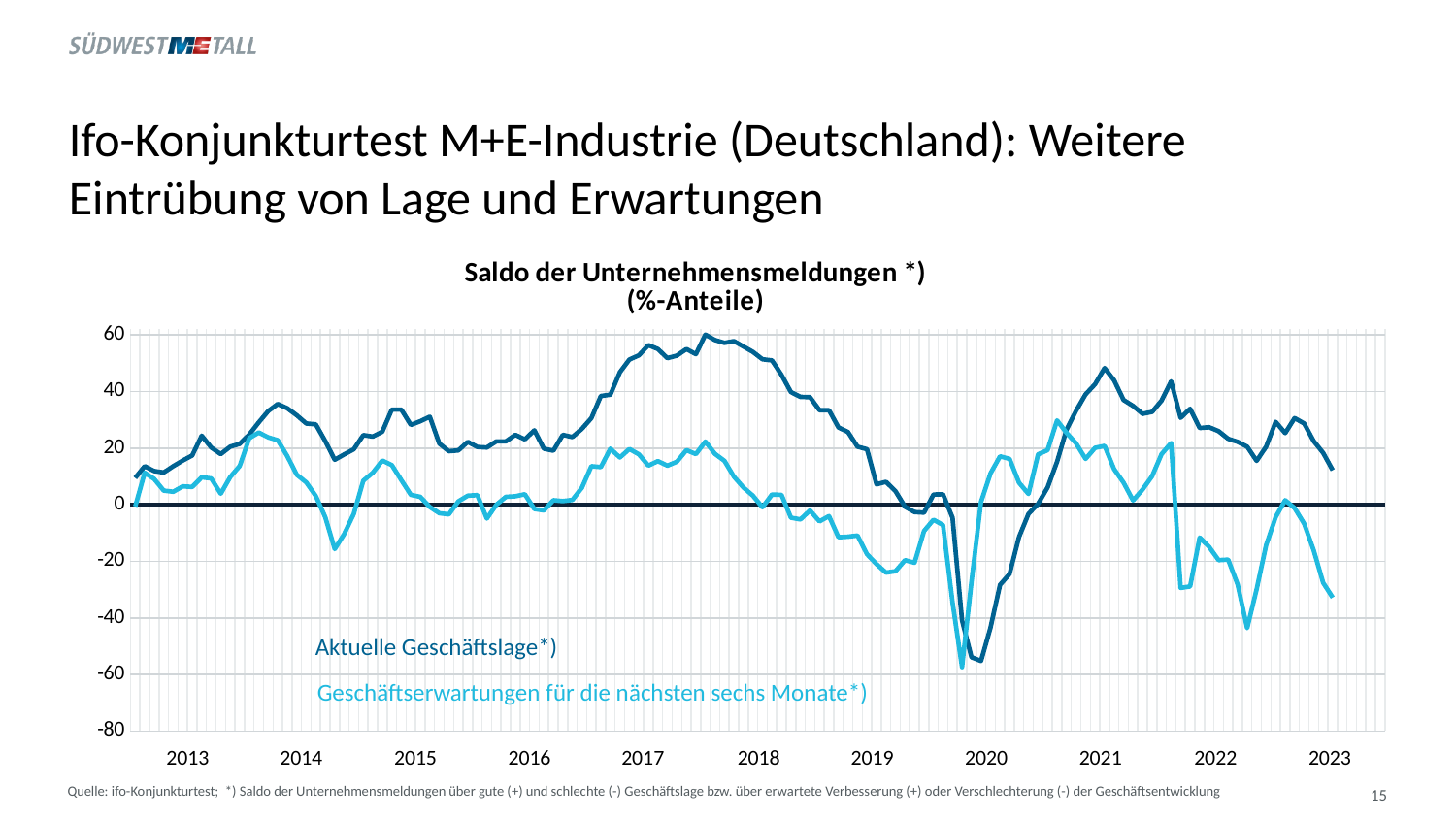
What kind of chart is shown on the slide? line chart How many year labels are shown on the x axis? 11 Which series is drawn in the lighter blue colour? Geschäftserwartungen für die nächsten sechs Monate*) What is the title of the chart? Saldo der Unternehmensmeldungen *) (%-Anteile) Is the last plotted value of Geschäftserwartungen in 2023 greater or less than -20? less Does the Aktuelle Geschäftslage series rise or fall from its 2021 peak to the end of the series in 2023? fall Is the lowest value of Geschäftserwartungen in 2020 greater or less than -40? less At the end of the series in 2023, which series has the higher value, Aktuelle Geschäftslage or Geschäftserwartungen? Aktuelle Geschäftslage How many series are plotted in the chart? 2 In which year does the Geschäftserwartungen series reach its lowest value? 2020 In which year does the Aktuelle Geschäftslage series reach its highest value? 2017 Is the peak value of Aktuelle Geschäftslage in 2017 greater or less than 40? greater